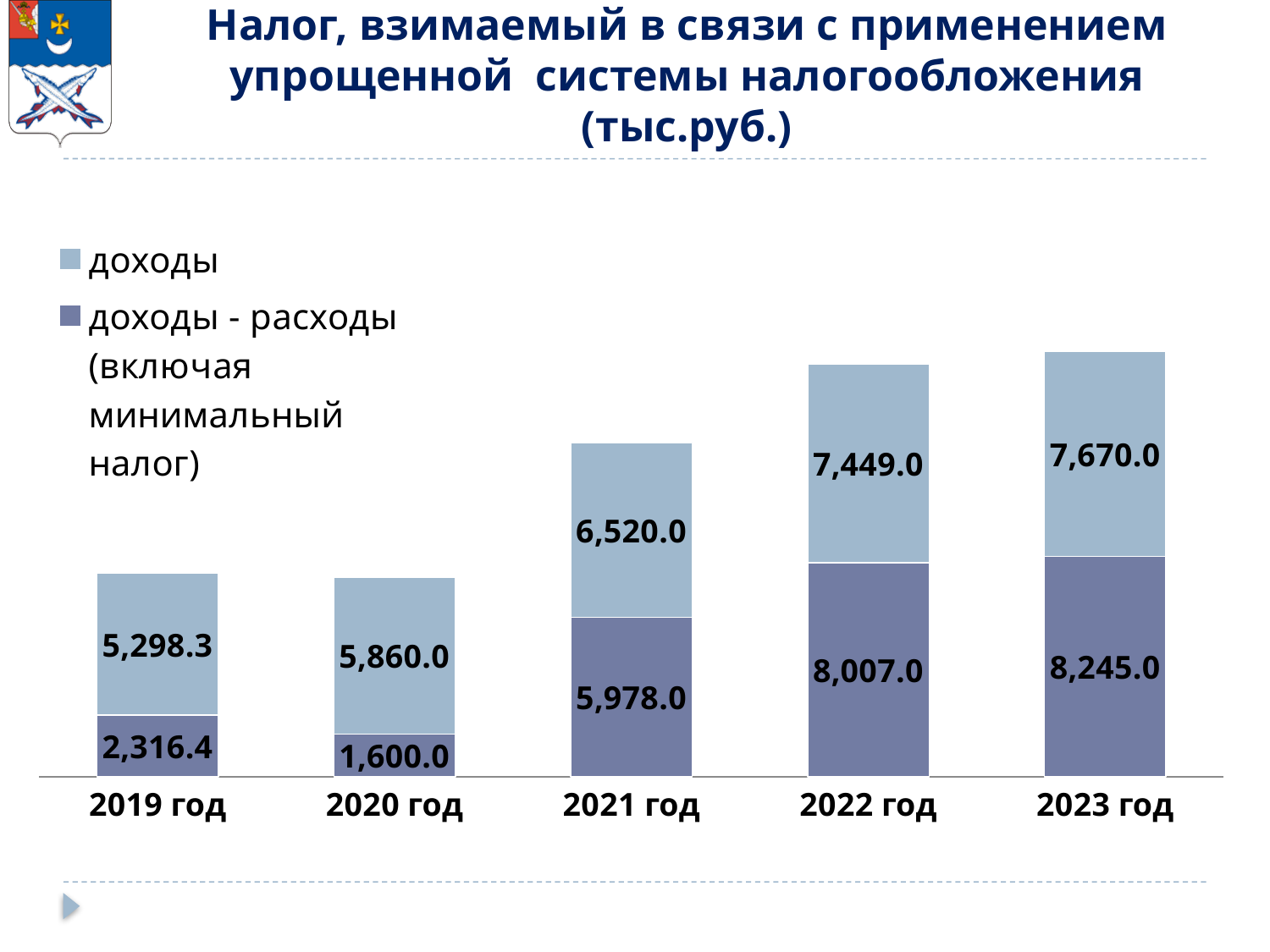
How many years are shown on the x axis? 5 What kind of chart is shown on the slide? Stacked bar chart How many series does the legend list? 2 In which year is the 'доходы' series highest? 2023 год What is the value of the 'доходы' series for 2021 год? 6,520.0 In which year is the 'доходы - расходы (включая минимальный налог)' series lowest? 2020 год What is the total of the stacked bar for 2021 год? 12,498.0 What is the value of the 'доходы - расходы (включая минимальный налог)' series for 2023 год? 8,245.0 What is the value of the 'доходы - расходы (включая минимальный налог)' series for 2020 год? 1,600.0 Which is larger in 2022 год: the 'доходы' value or the 'доходы - расходы (включая минимальный налог)' value? доходы - расходы (включая минимальный налог) Does the 'доходы - расходы (включая минимальный налог)' series rise or fall from 2020 год to 2023 год? Rise What is the difference between the 'доходы' values for 2023 год and 2022 год? 221.0